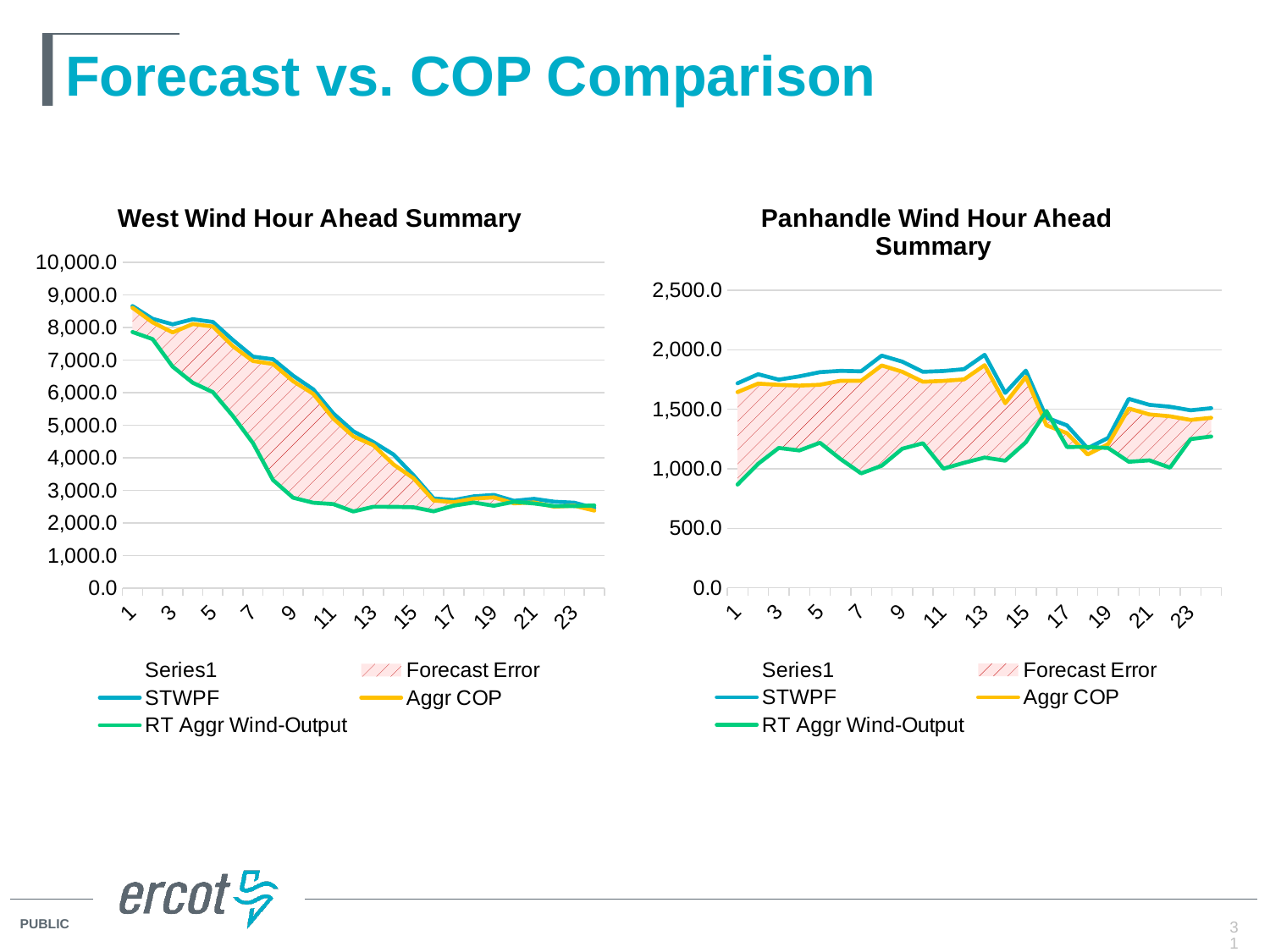
In the West Wind Hour Ahead Summary chart, does the RT Aggr Wind-Output series rise or fall from hour 1 to hour 13? fall In the West Wind Hour Ahead Summary chart, is the RT Aggr Wind-Output value at hour 13 greater or less than 3,000? less In the Panhandle Wind Hour Ahead Summary chart, which is larger at hour 5: STWPF or RT Aggr Wind-Output? STWPF In the West Wind Hour Ahead Summary chart, which is larger at hour 9: STWPF or RT Aggr Wind-Output? STWPF In the Panhandle Wind Hour Ahead Summary chart, is the STWPF value at hour 13 greater or less than 1,500? greater In the Panhandle Wind Hour Ahead Summary chart, is the RT Aggr Wind-Output value at hour 1 greater or less than 1,000? less What kind of chart is the West Wind Hour Ahead Summary? combination area and line chart What is the title of the chart on the right side of the slide? Panhandle Wind Hour Ahead Summary In the West Wind Hour Ahead Summary chart, does the STWPF series rise or fall from hour 1 to hour 16? fall How many series does the legend of the Panhandle Wind Hour Ahead Summary chart list? 5